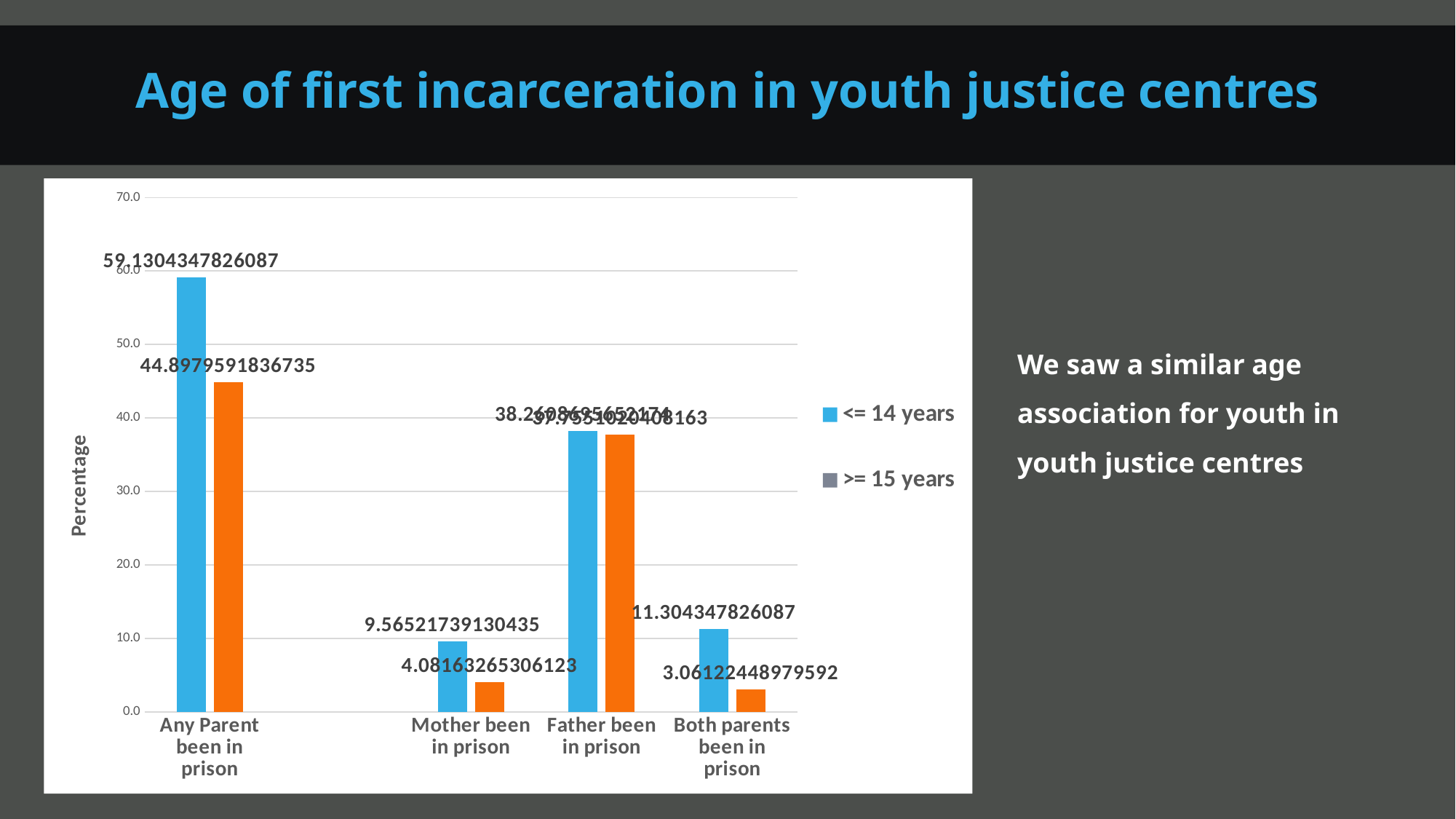
What is the value for "<= 14 years" in the "Mother been in prison" category? 9.56521739130435 Which category has the lowest value for the ">= 15 years" series? Both parents been in prison How many series does the chart's legend list? 2 What is the value for ">= 15 years" in the "Any Parent been in prison" category? 44.8979591836735 What is the value for "<= 14 years" in the "Any Parent been in prison" category? 59.1304347826087 What is the difference between the "<= 14 years" and ">= 15 years" values for "Any Parent been in prison"? 14.2324755989352 Is the "<= 14 years" value for "Father been in prison" greater or less than 30.0? greater How many categories are shown on the x axis of the chart? 4 What is the value for ">= 15 years" in the "Both parents been in prison" category? 3.06122448979592 What is the value for "<= 14 years" in the "Both parents been in prison" category? 11.304347826087 Which category has the highest value for the "<= 14 years" series? Any Parent been in prison In the "Mother been in prison" category, which series has the larger value, "<= 14 years" or ">= 15 years"? <= 14 years